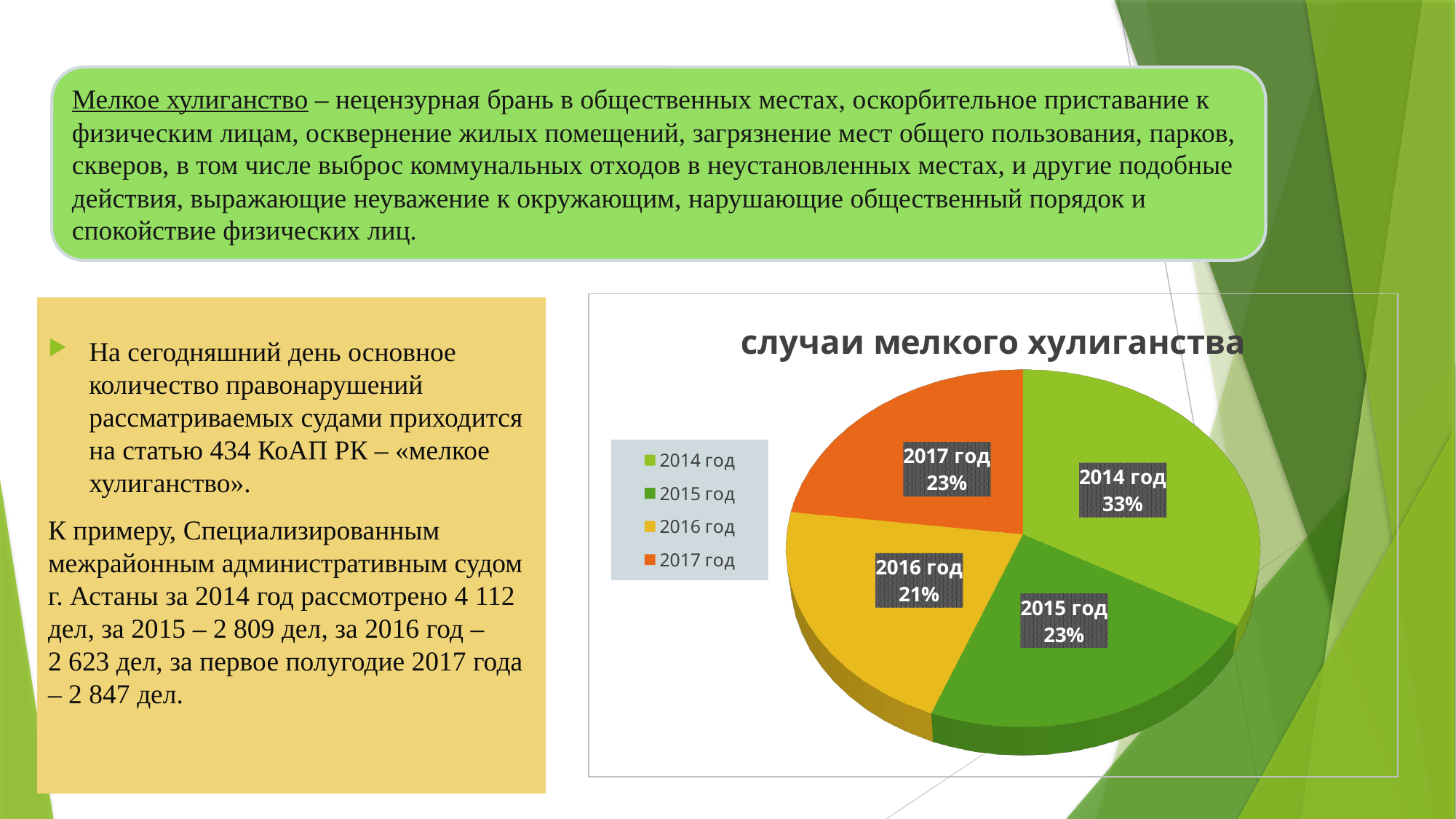
What is the title of the chart? случаи мелкого хулиганства Which year has the largest slice of the pie? 2014 год What is the difference in percentage points between 2014 год and 2016 год? 12 What is the value shown for 2015 год? 23% What kind of chart is shown on the slide? pie chart What share of the pie does 2014 год have? 33% How many slices does the pie chart have? 4 How many entries does the legend list? 4 Which year has the smallest slice of the pie? 2016 год What is the value shown for 2016 год? 21% Which is larger, the slice for 2014 год or the slice for 2016 год? 2014 год What is the value shown for 2017 год? 23%